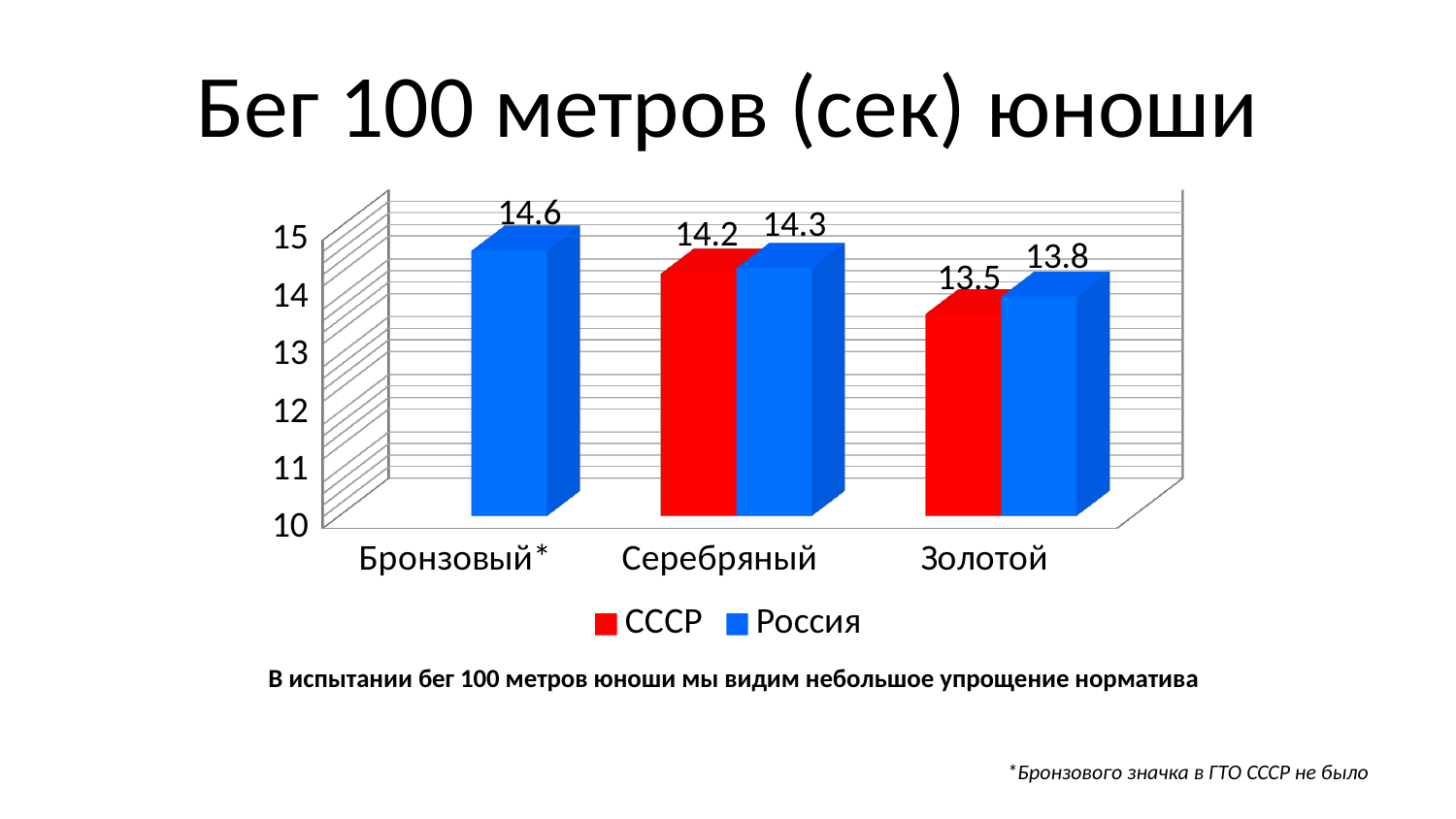
What is the value for СССР in the Золотой category? 13.5 What kind of chart is shown on the slide? Bar chart How many categories are shown on the x axis? 3 Which is larger in the Серебряный category: the СССР value or the Россия value? Россия Which category has the highest value for Россия? Бронзовый What is the value for Россия in the Бронзовый category? 14.6 Which category has the lowest value for СССР? Золотой What is the value for СССР in the Серебряный category? 14.2 What is the difference between the Россия and СССР values in the Золотой category? 0.3 How many series does the legend list? 2 What is the title of the chart? Бег 100 метров (сек) юноши What is the value for Россия in the Золотой category? 13.8